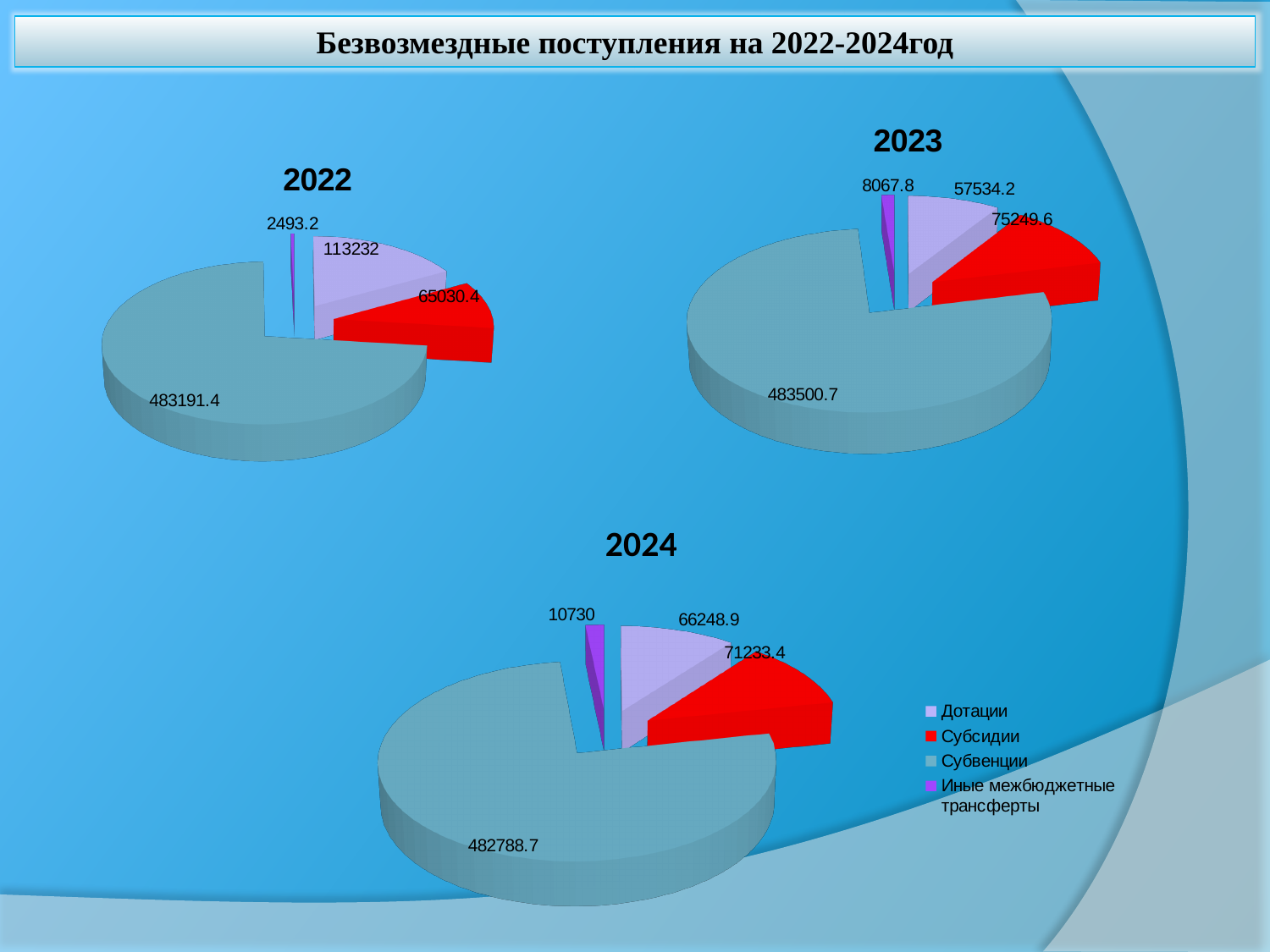
In the 2023 pie chart, what is the difference between Субсидии and Дотации? 17715.4 In the 2022 pie chart, what is the difference between Дотации and Субсидии? 48201.6 In the 2022 pie chart, which is larger: Дотации or Субсидии? Дотации What type of chart is used for 2023? Pie chart In the 2023 pie chart, what is the value for Субсидии? 75249.6 Which colour represents Субсидии in the legend? Red In the 2023 pie chart, which category has the smallest value? Иные межбюджетные трансферты In the 2022 pie chart, what is the value for Дотации? 113232 In the 2022 pie chart, what is the value for Субвенции? 483191.4 In the 2024 pie chart, what is the value for Иные межбюджетные трансферты? 10730 How many slices does the 2024 pie chart have? 4 In the 2024 pie chart, which category has the largest value? Субвенции